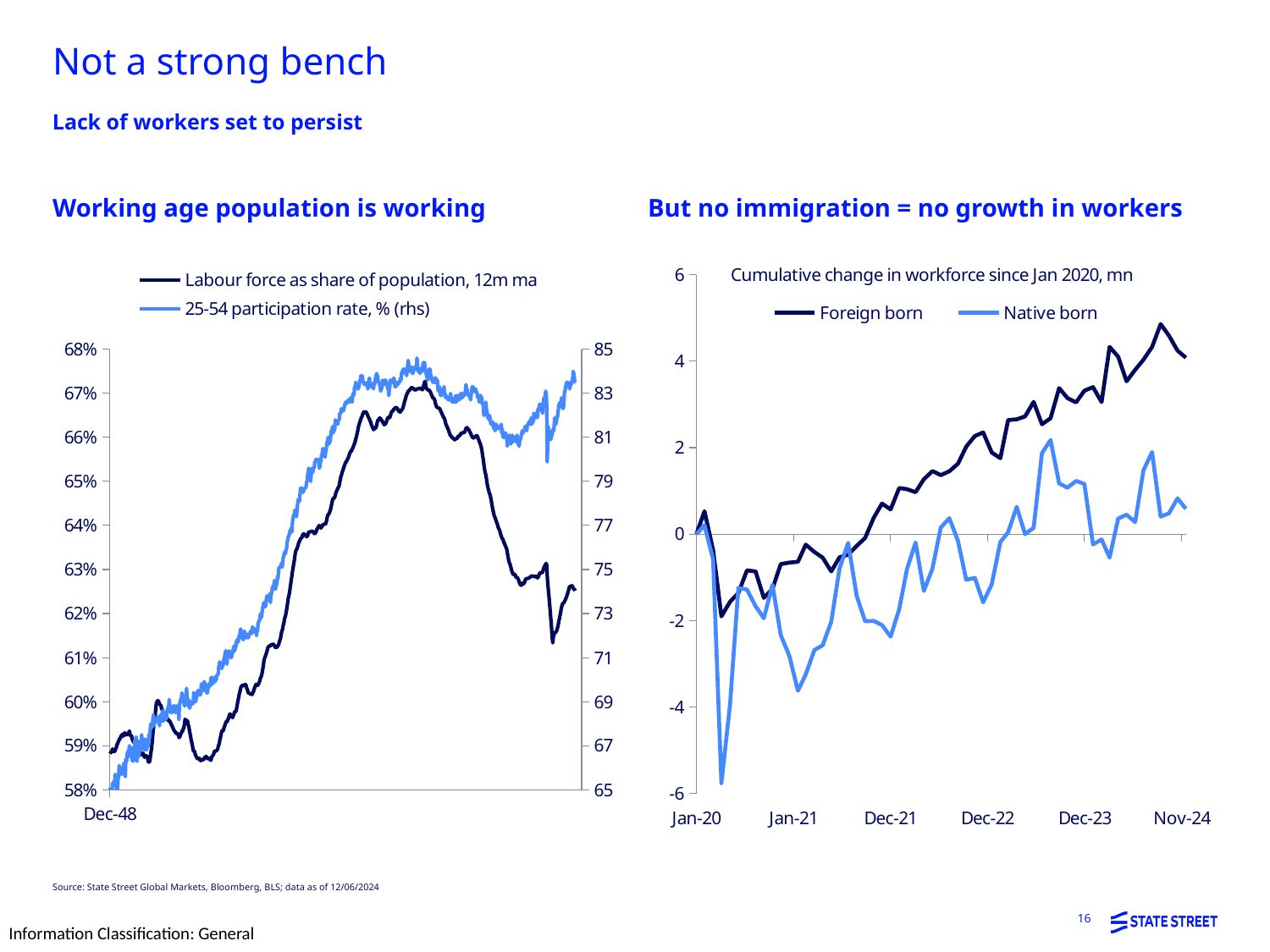
In the right chart, which series is higher at Nov-24, Foreign born or Native born? Foreign born What kind of chart is the left chart, 'Working age population is working'? line chart How many series does the legend of the left chart list? 2 What is the first legend entry of the left chart? Labour force as share of population, 12m ma In the left chart, is the '25-54 participation rate, % (rhs)' value at the end of the series greater or less than 81? greater In the right chart, is the Foreign born value at Nov-24 greater or less than 2? greater In the right chart, is the lowest point of the Native born series greater or less than -4? less In the right chart, does the Foreign born series generally rise or fall from Jan-20 to Nov-24? rise How many series does the legend of the right chart, 'Cumulative change in workforce since Jan 2020, mn', list? 2 In the right chart, which series is higher at Dec-22, Foreign born or Native born? Foreign born What is the title printed inside the right chart? Cumulative change in workforce since Jan 2020, mn